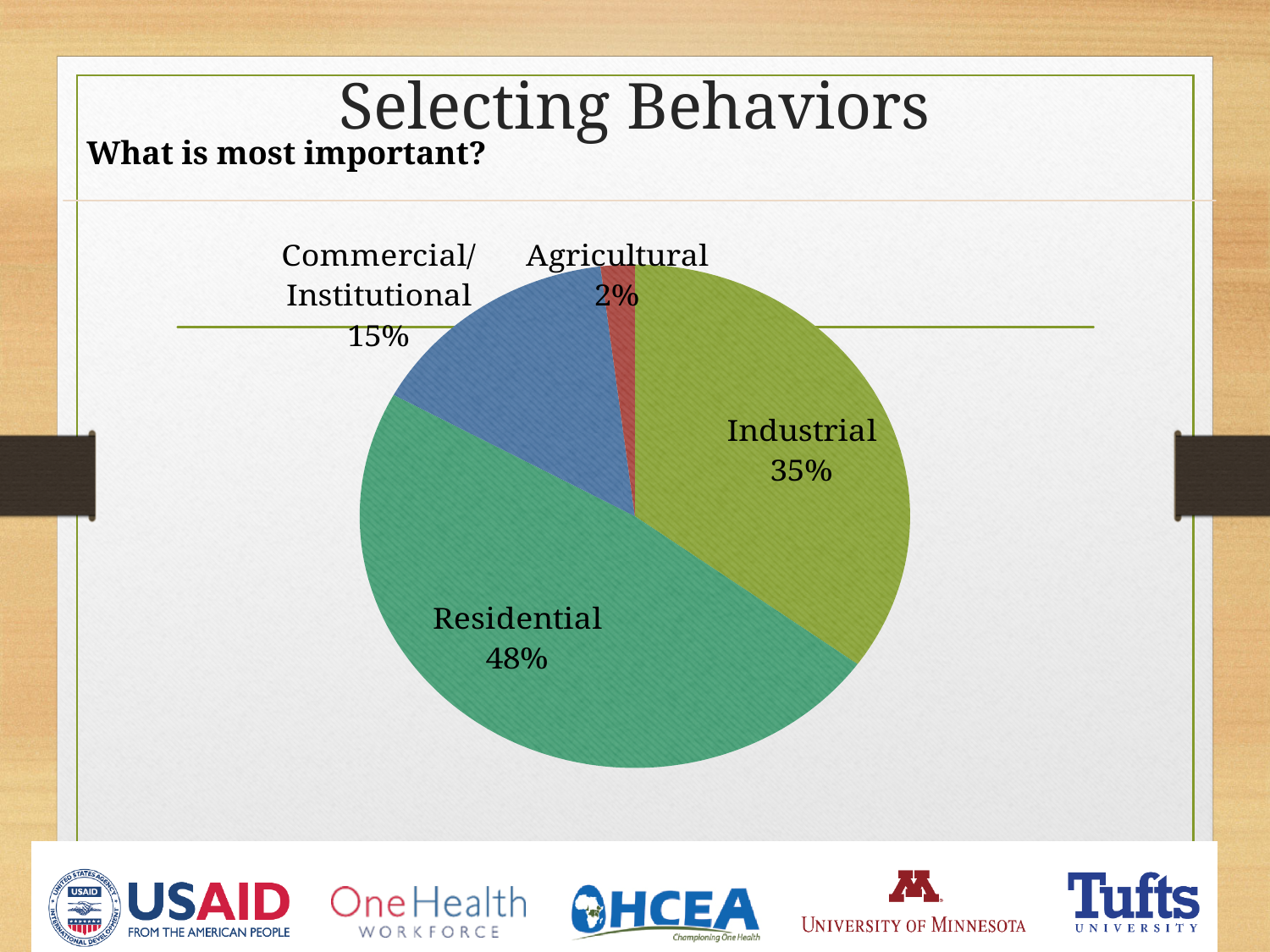
What kind of chart is shown on the slide? pie chart Which is larger, the Industrial slice or the Commercial/Institutional slice? Industrial Which category has the smallest share of the pie? Agricultural How many slices does the pie chart have? 4 What colour is the Residential slice? green What percentage does the Commercial/Institutional slice represent? 15% What percentage does the Agricultural slice represent? 2% What percentage does the Residential slice represent? 48% What is the difference in percentage points between the Residential and Industrial slices? 13 Which category has the largest share of the pie? Residential What percentage does the Industrial slice represent? 35% What is the combined share of the Commercial/Institutional and Agricultural slices? 17%